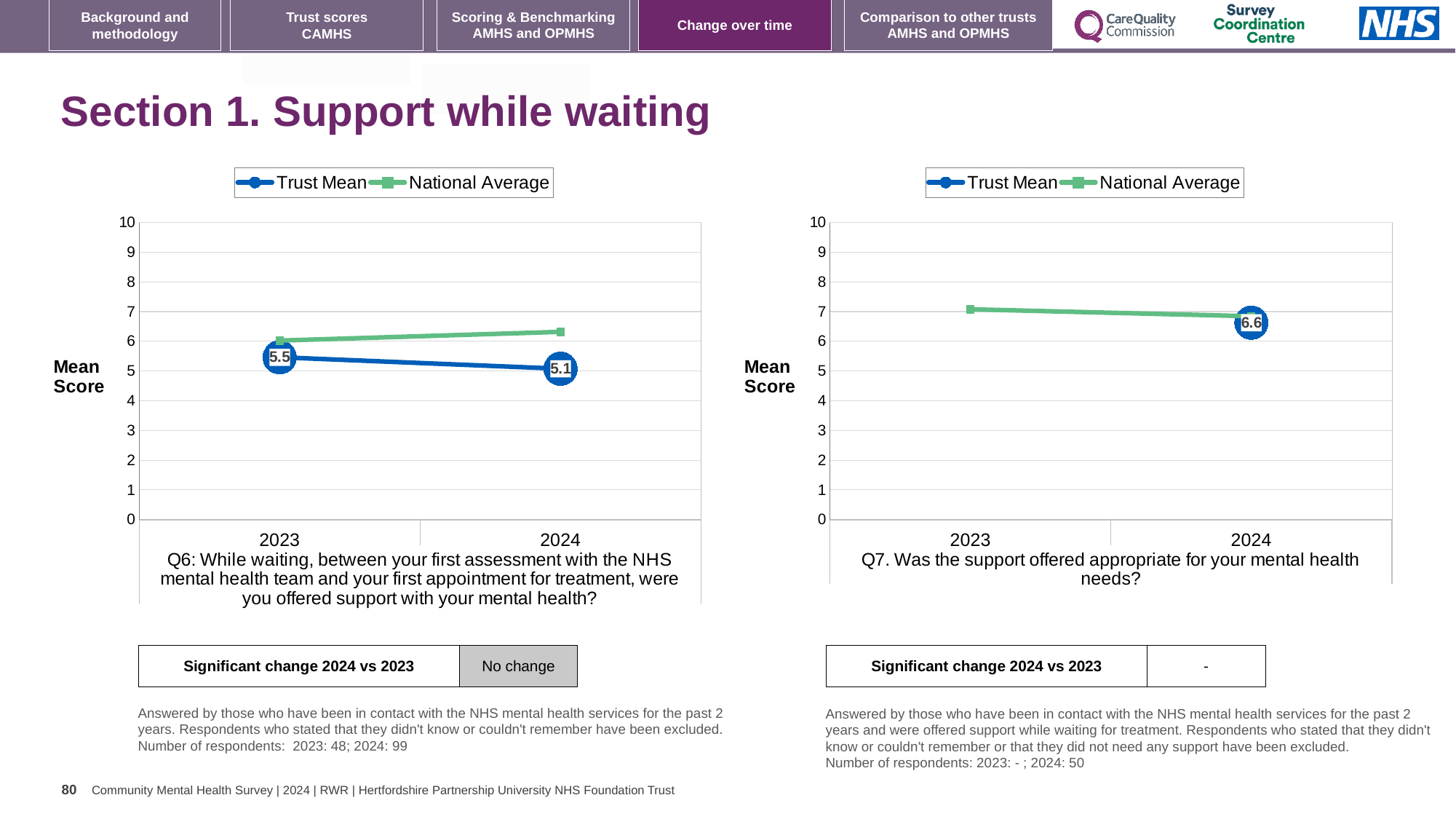
In the left chart (Q6), what is the Trust Mean score for 2024? 5.1 In the left chart (Q6), what is the Trust Mean score for 2023? 5.5 In the left chart (Q6), is the National Average for 2024 greater or less than 6? greater In the left chart (Q6), does the Trust Mean rise or fall from 2023 to 2024? fall What kind of chart is the left chart (Q6)? line chart How many years are shown on the x axis of the right chart (Q7)? 2 How many series does the legend of the right chart (Q7) list? 2 In the right chart (Q7), what is the Trust Mean score for 2024? 6.6 In the left chart (Q6), which year has the higher Trust Mean, 2023 or 2024? 2023 In the left chart (Q6), is the National Average for 2024 higher or lower than the Trust Mean for 2024? higher In the left chart (Q6), by how much did the Trust Mean change from 2023 to 2024? 0.4